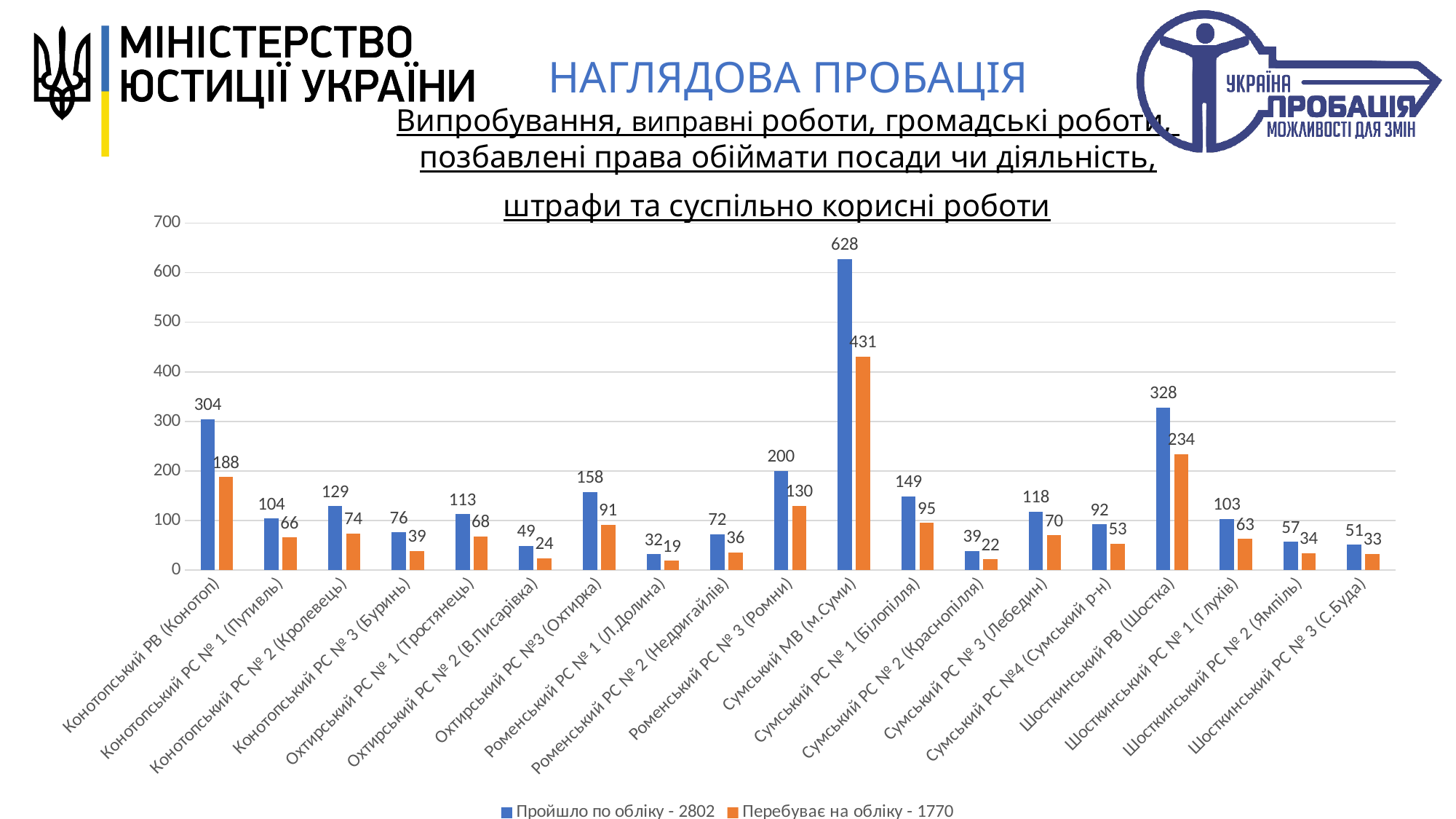
Is the value of 'Пройшло по обліку' for Шосткинський РВ (Шостка) greater or less than 300? greater How many categories are shown on the x axis? 19 Which category has the highest value for 'Пройшло по обліку'? Сумський МВ (м.Суми) Which is larger: 'Пройшло по обліку' for Охтирський РС №3 (Охтирка) or for Сумський РС № 1 (Білопілля)? Охтирський РС №3 (Охтирка) What is the value of 'Пройшло по обліку' for Роменський РС № 3 (Ромни)? 200 How many series does the legend list? 2 What is the difference between 'Пройшло по обліку' and 'Перебуває на обліку' for Конотопський РВ (Конотоп)? 116 What total is given in the legend for the series 'Перебуває на обліку'? 1770 What is the value of 'Перебуває на обліку' for Шосткинський РВ (Шостка)? 234 Which category has the lowest value for 'Перебуває на обліку'? Роменський РС № 1 (Л.Долина) What is the value of 'Пройшло по обліку' for Сумський МВ (м.Суми)? 628 What kind of chart is shown on the slide? bar chart